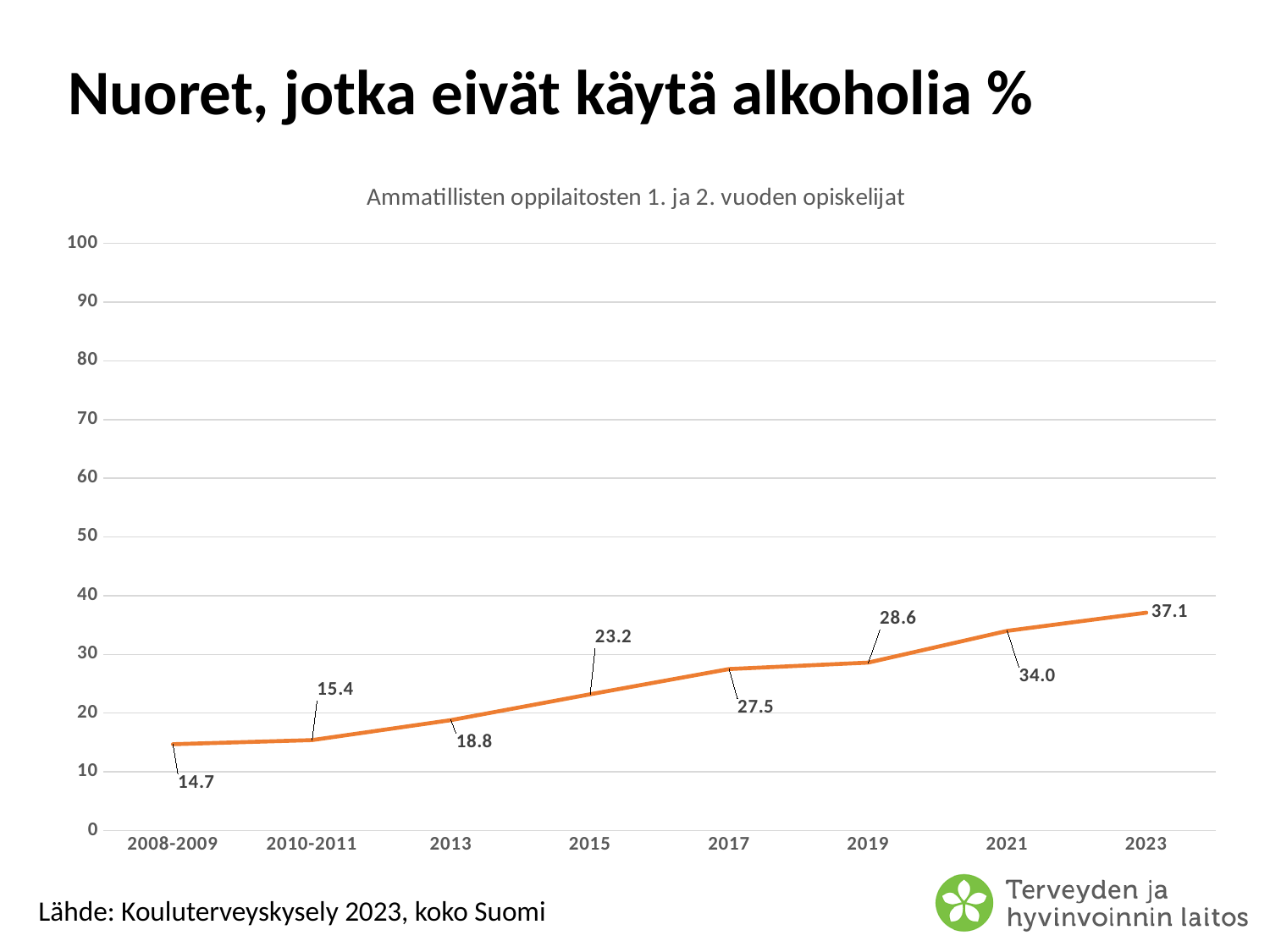
What is the value for 2013? 18.8 Is the value for 2021 greater or less than 30? greater Do the values rise or fall from 2008-2009 to 2023? rise How many data points are plotted on the chart? 8 Which is larger, the value for 2019 or the value for 2015? 2019 What kind of chart is shown on the slide? line chart Which year has the highest value? 2023 What is the difference between the values for 2023 and 2008-2009? 22.4 What is the value for 2008-2009? 14.7 What is the value for 2017? 27.5 What is the value for 2023? 37.1 Which year has the lowest value? 2008-2009